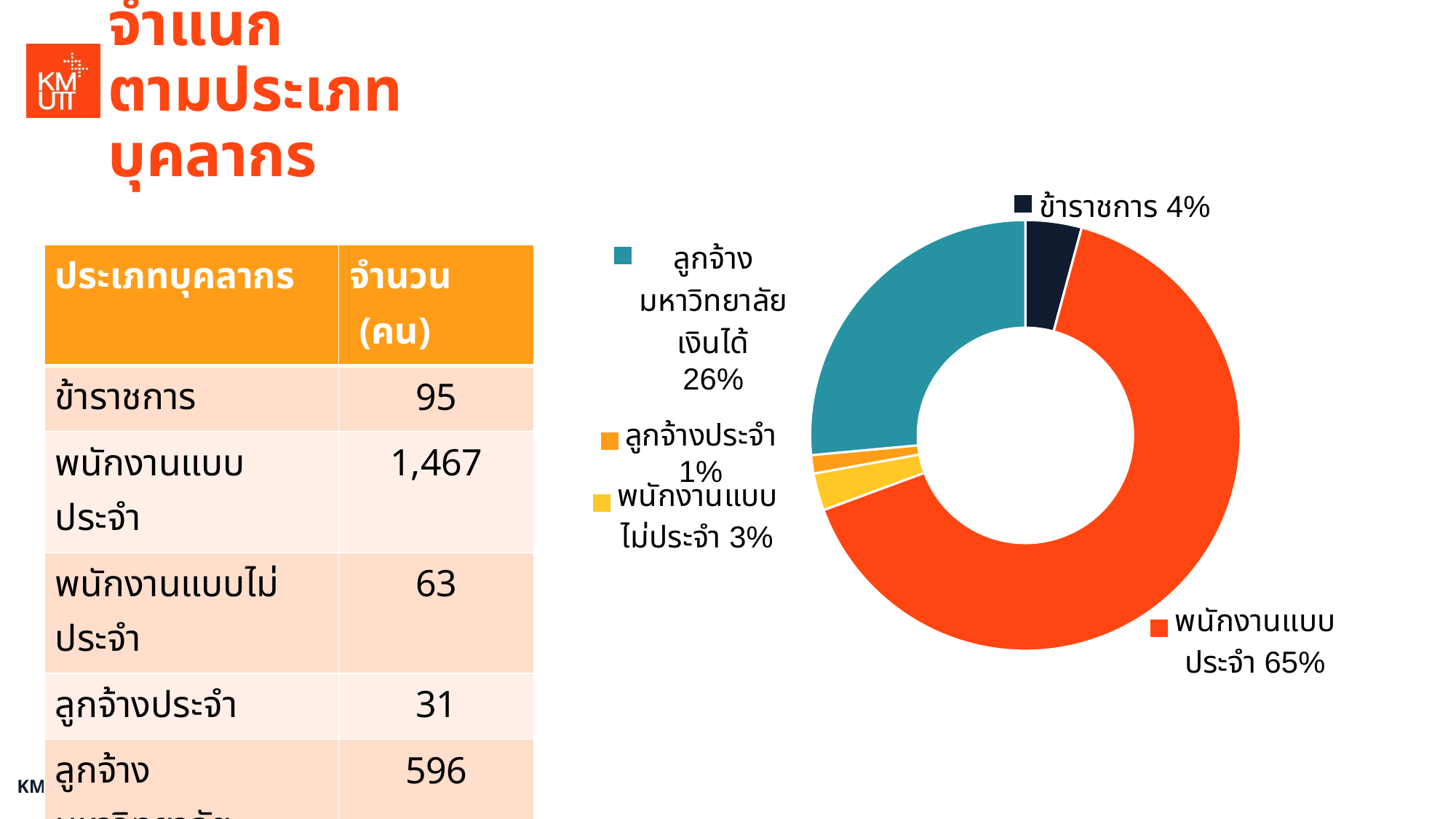
Which slice is larger in the pie chart, ข้าราชการ or ลูกจ้างมหาวิทยาลัยเงินได้? ลูกจ้างมหาวิทยาลัยเงินได้ What percentage share does the ลูกจ้างประจำ slice have in the pie chart? 1% What kind of chart is shown on the slide? Pie chart (donut) Which category has the largest slice in the pie chart? พนักงานแบบประจำ How many slices does the pie chart have? 5 What percentage share does the พนักงานแบบไม่ประจำ slice have in the pie chart? 3% What colour is the พนักงานแบบประจำ slice in the pie chart? Orange-red What percentage share does the ลูกจ้างมหาวิทยาลัยเงินได้ slice have in the pie chart? 26% Which category has the smallest slice in the pie chart? ลูกจ้างประจำ What is the difference in percentage points between the พนักงานแบบประจำ slice and the ลูกจ้างมหาวิทยาลัยเงินได้ slice? 39%